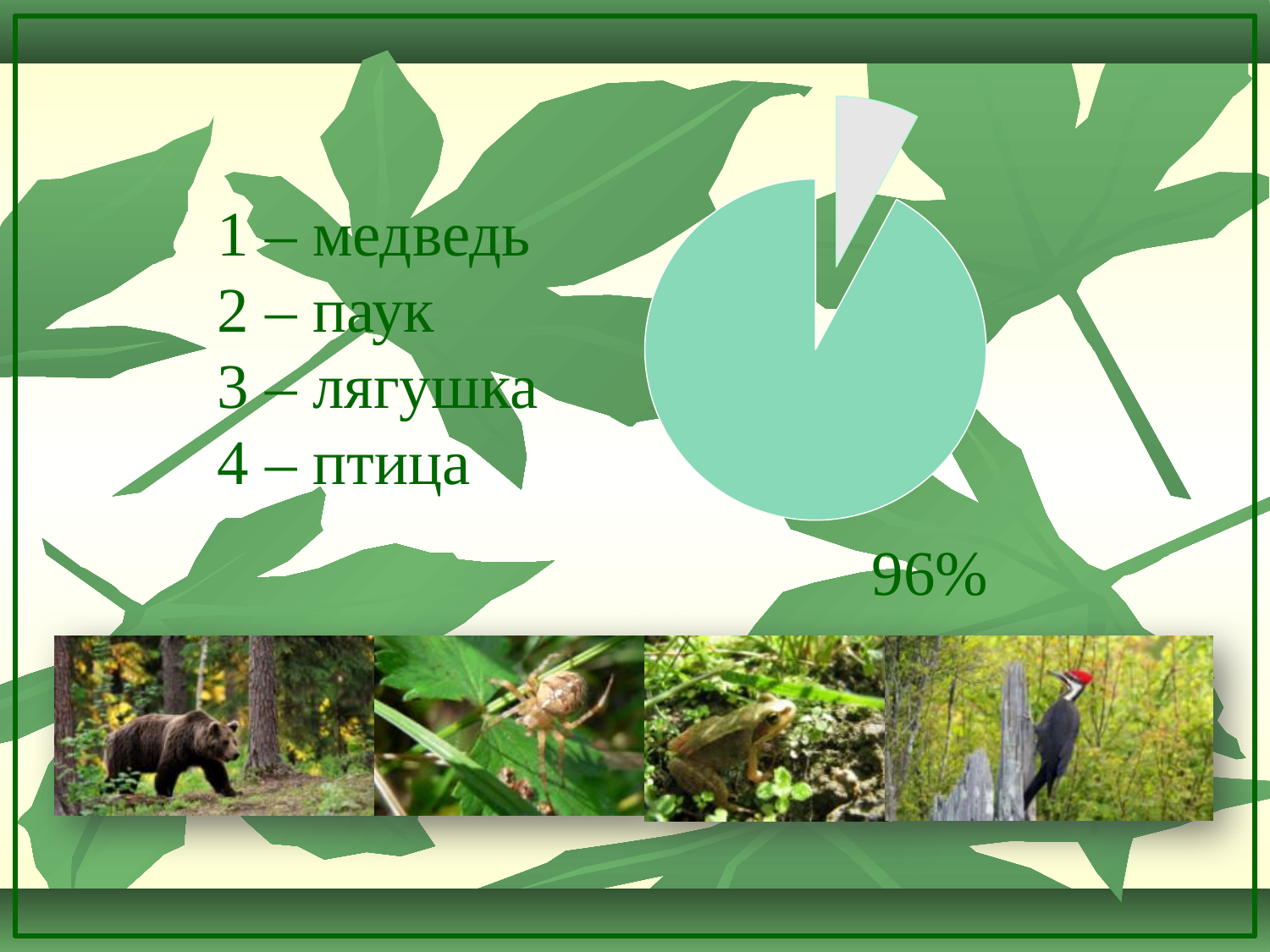
What percentage value is printed next to the pie chart? 96% How many slices does the pie chart have? 2 What colour is the small exploded slice of the pie chart? grey What kind of chart is shown on the slide? pie chart Which slice of the pie chart is larger, the teal one or the grey one? the teal one Is the share of the largest slice greater or less than 50%? greater Which slice is pulled out from the pie chart, the large one or the small one? the small one What share of the pie does the largest slice represent? 96%